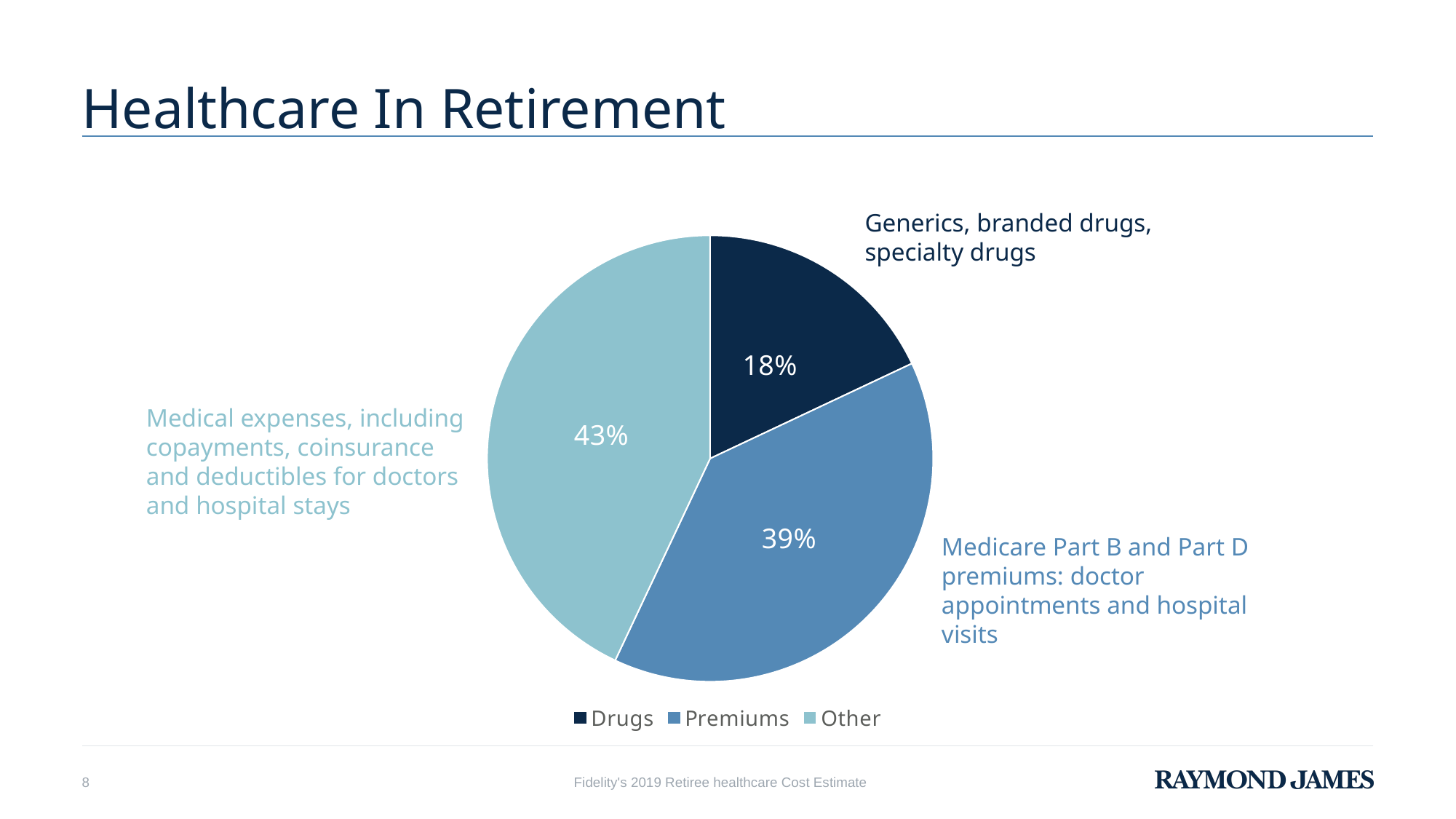
What share of the pie does Drugs represent? 18% Which category has the smallest slice of the pie? Drugs How many entries does the legend list? 3 Which legend entry is shown in the darkest blue colour? Drugs What share of the pie does Other represent? 43% What kind of chart is shown on the slide? pie chart What share of the pie does Premiums represent? 39% Which category has the largest slice of the pie? Other What is the difference between the Other share and the Drugs share? 25% What is the difference between the Other share and the Premiums share? 4% Which is larger, the Premiums slice or the Drugs slice? Premiums How many slices does the pie chart have? 3